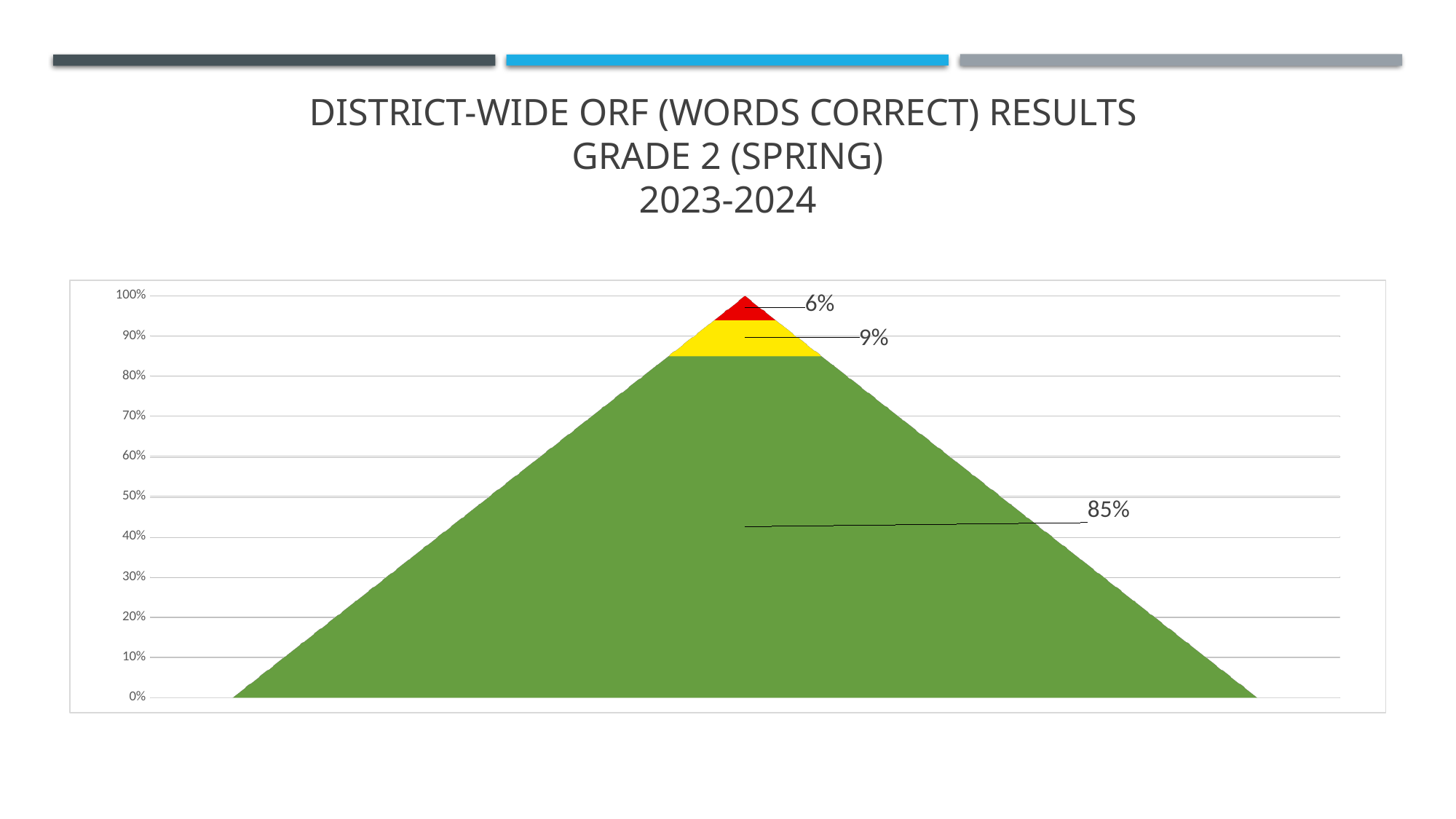
How many data labels are shown on the chart? 3 What is the total of the three labelled segments? 100% What value is labelled on the red segment at the top of the chart? 6% Which coloured segment has the smallest value? Red What is the highest value shown on the vertical axis? 100% Which coloured segment has the largest value? Green What value is labelled on the green segment of the chart? 85% What is the difference between the yellow segment's value and the red segment's value? 3% What is the difference between the green segment's value and the yellow segment's value? 76% Which is larger, the yellow segment's value or the red segment's value? Yellow Which grade and season does the chart title refer to? Grade 2 (Spring) What value is labelled on the yellow segment of the chart? 9%